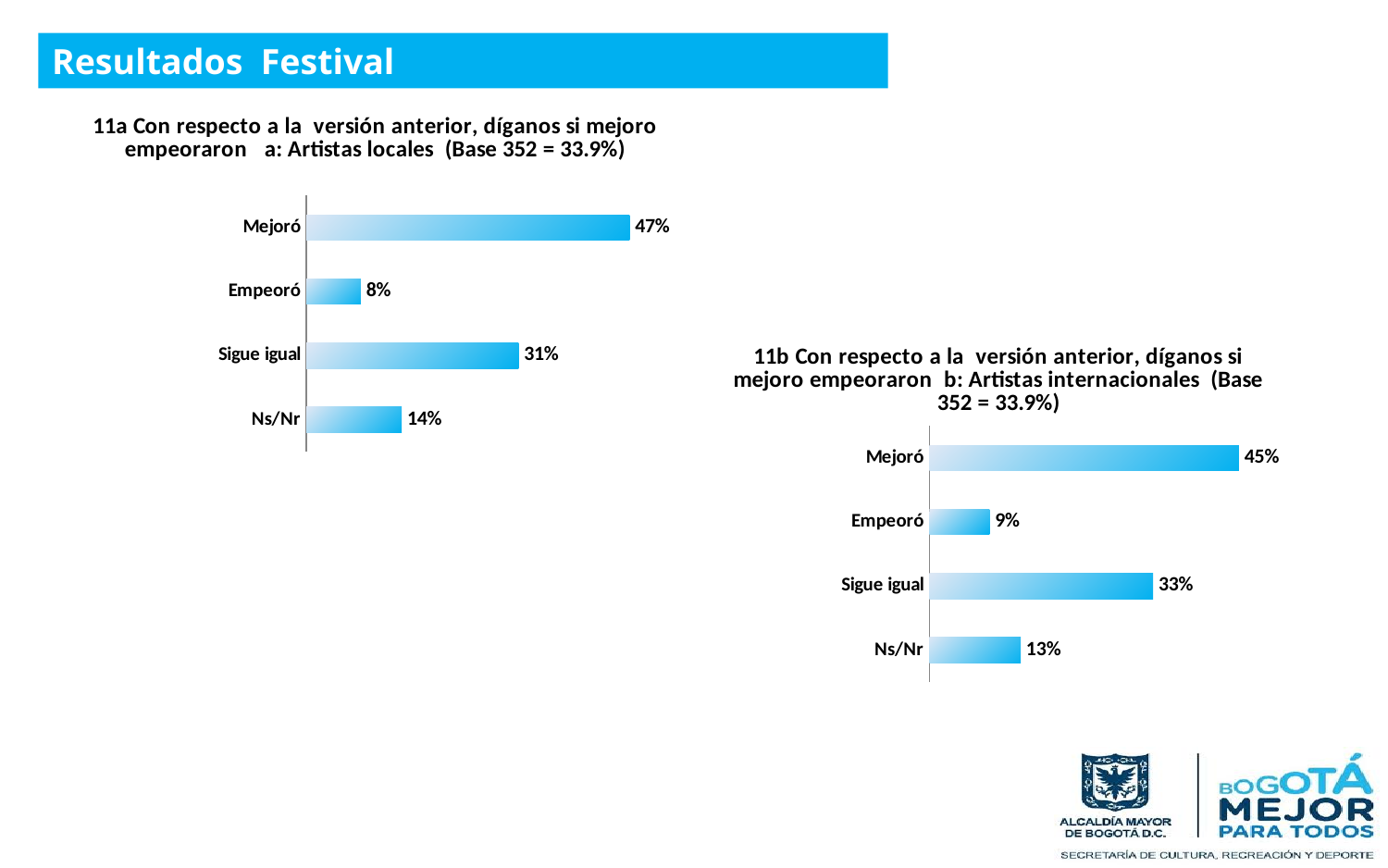
In the 'Artistas internacionales' chart (11b, right), what is the value for Sigue igual? 33% What base is stated in the title of the 'Artistas locales' chart (11a, left)? Base 352 = 33.9% In the 'Artistas locales' chart (11a, left), what is the value for Mejoró? 47% How many categories are shown in the 'Artistas internacionales' chart (11b, right)? 4 In the 'Artistas locales' chart (11a, left), what is the difference between Mejoró and Sigue igual? 16% In the 'Artistas locales' chart (11a, left), which is larger: Ns/Nr or Empeoró? Ns/Nr In the 'Artistas internacionales' chart (11b, right), what is the difference between Ns/Nr and Empeoró? 4% What kind of chart is the 'Artistas locales' chart (11a, left)? Bar chart In the 'Artistas locales' chart (11a, left), which category has the lowest value? Empeoró In the 'Artistas internacionales' chart (11b, right), what is the value for Ns/Nr? 13% Which chart has the higher value for Mejoró: 'Artistas locales' (11a) or 'Artistas internacionales' (11b)? Artistas locales (11a) In the 'Artistas internacionales' chart (11b, right), which category has the highest value? Mejoró